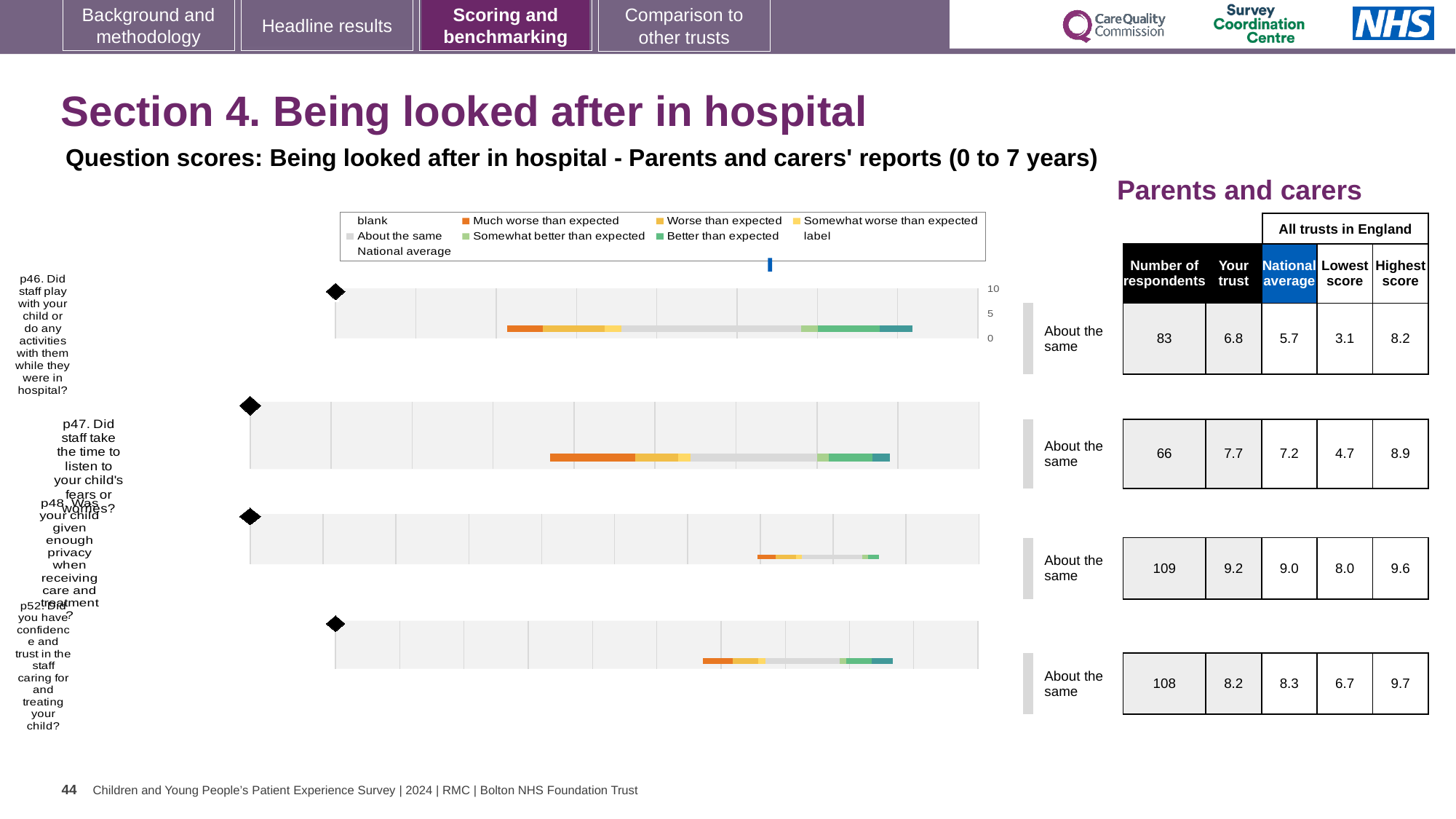
What is the 'Your trust' score for p46 (Did staff play with your child or do any activities with them while they were in hospital?)? 6.8 For p52, which is larger: the 'Your trust' score or the national average? National average What is the highest score across all trusts in England for p52 (Did you have confidence and trust in the staff caring for and treating your child?)? 9.7 For p48, what is the difference between the highest score and the lowest score across all trusts in England? 1.6 What kind of chart is used to show the question scores? Bar chart How many respondents answered p48 (Was your child given enough privacy when receiving care and treatment?)? 109 How many survey questions are plotted on the slide? 4 What colour does the legend use for 'Much worse than expected'? Orange Which question has the highest 'Your trust' score? p48 What benchmark category is shown for p46? About the same Which question has the lowest number of respondents? p47 What is the national average score for p47 (Did staff take the time to listen to your child's fears or worries?)? 7.2